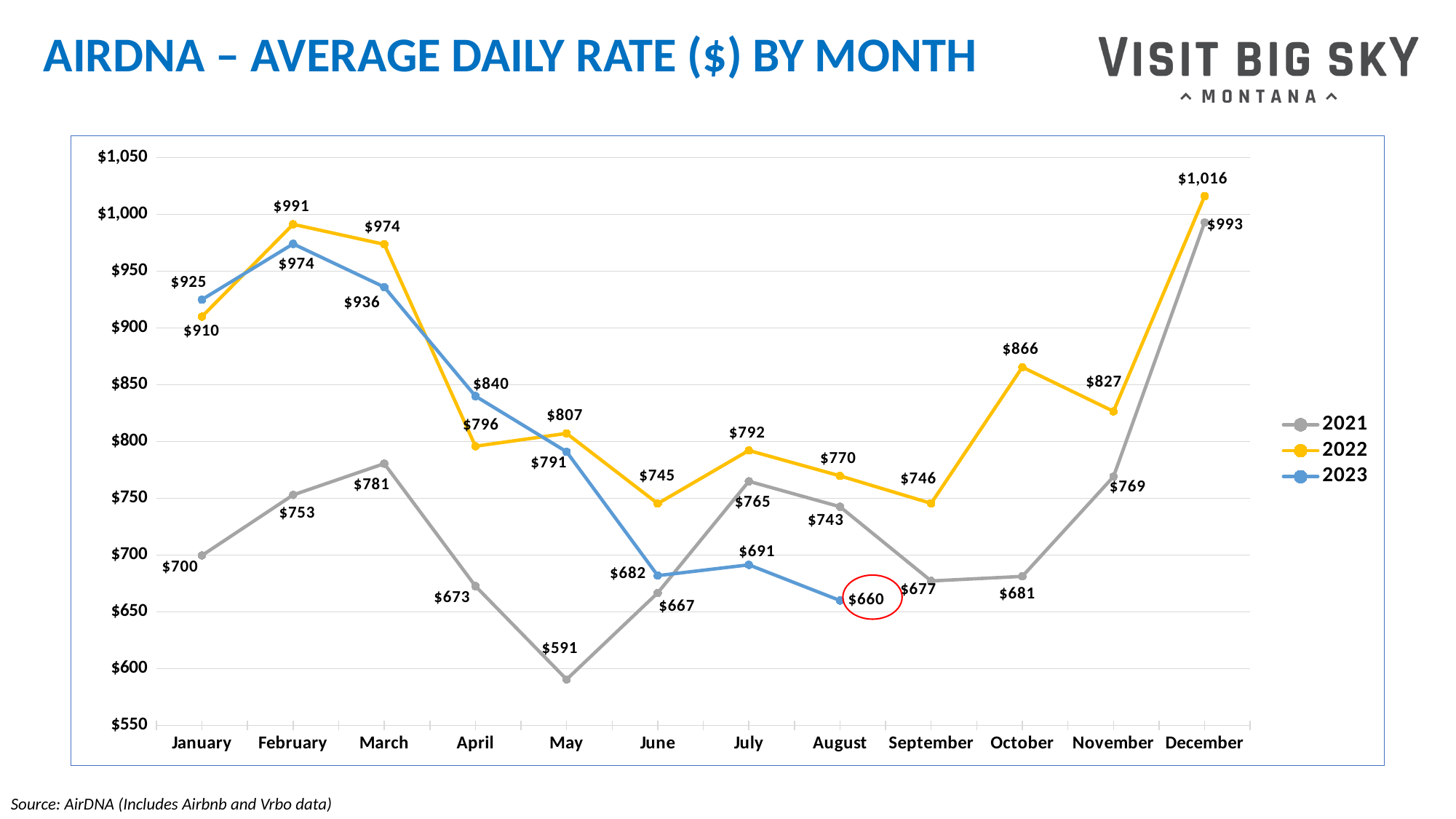
How many data points are plotted for the 2023 series? 8 In which month is the 2021 average daily rate highest? December What kind of chart is shown on the slide? Line chart How many series does the legend list? 3 What is the difference between the 2022 and 2021 average daily rates in February? $238 How many months are shown on the x axis? 12 What is the 2021 average daily rate for May? $591 Which year had the higher average daily rate in March, 2022 or 2023? 2022 In which month is the 2023 average daily rate highest? February What is the 2022 average daily rate for December? $1,016 In which month is the 2021 average daily rate lowest? May What is the 2023 average daily rate for August? $660